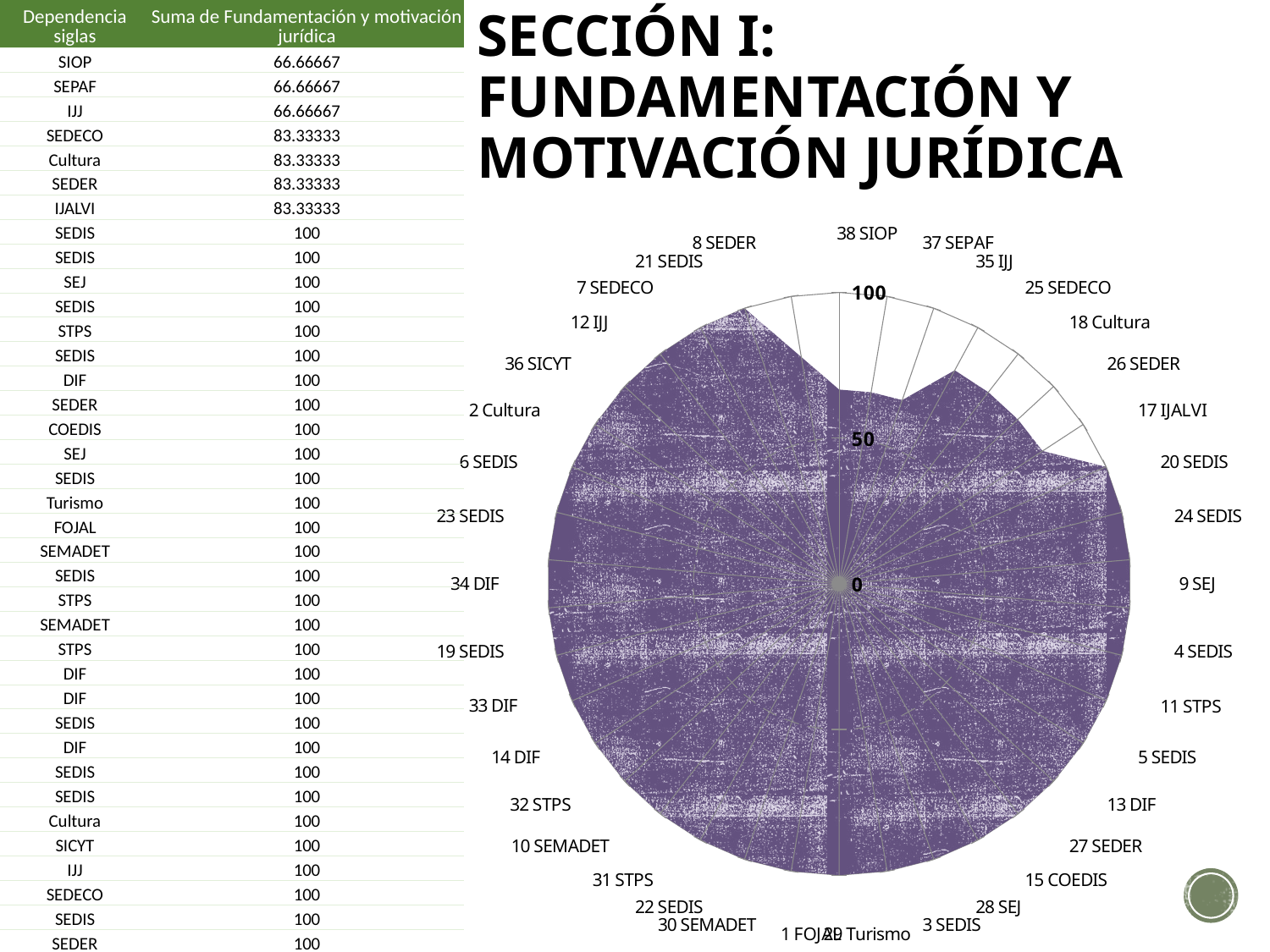
In the radar chart, which is larger, the value for 38 SIOP or the value for 20 SEDIS? 20 SEDIS In the radar chart, is the value for 38 SIOP greater or less than 100? less According to the table on the left, what is the value for SIOP? 66.66667 According to the table on the left, what is the value for COEDIS? 100 What kind of chart is shown on the right of the slide? radar chart What is the highest value marked on the radial axis of the radar chart? 100 What is the heading of the value column in the table on the left? Suma de Fundamentación y motivación jurídica In the radar chart, is the value for 38 SIOP greater or less than 50? greater In the radar chart, is the value for 9 SEJ greater or less than 50? greater